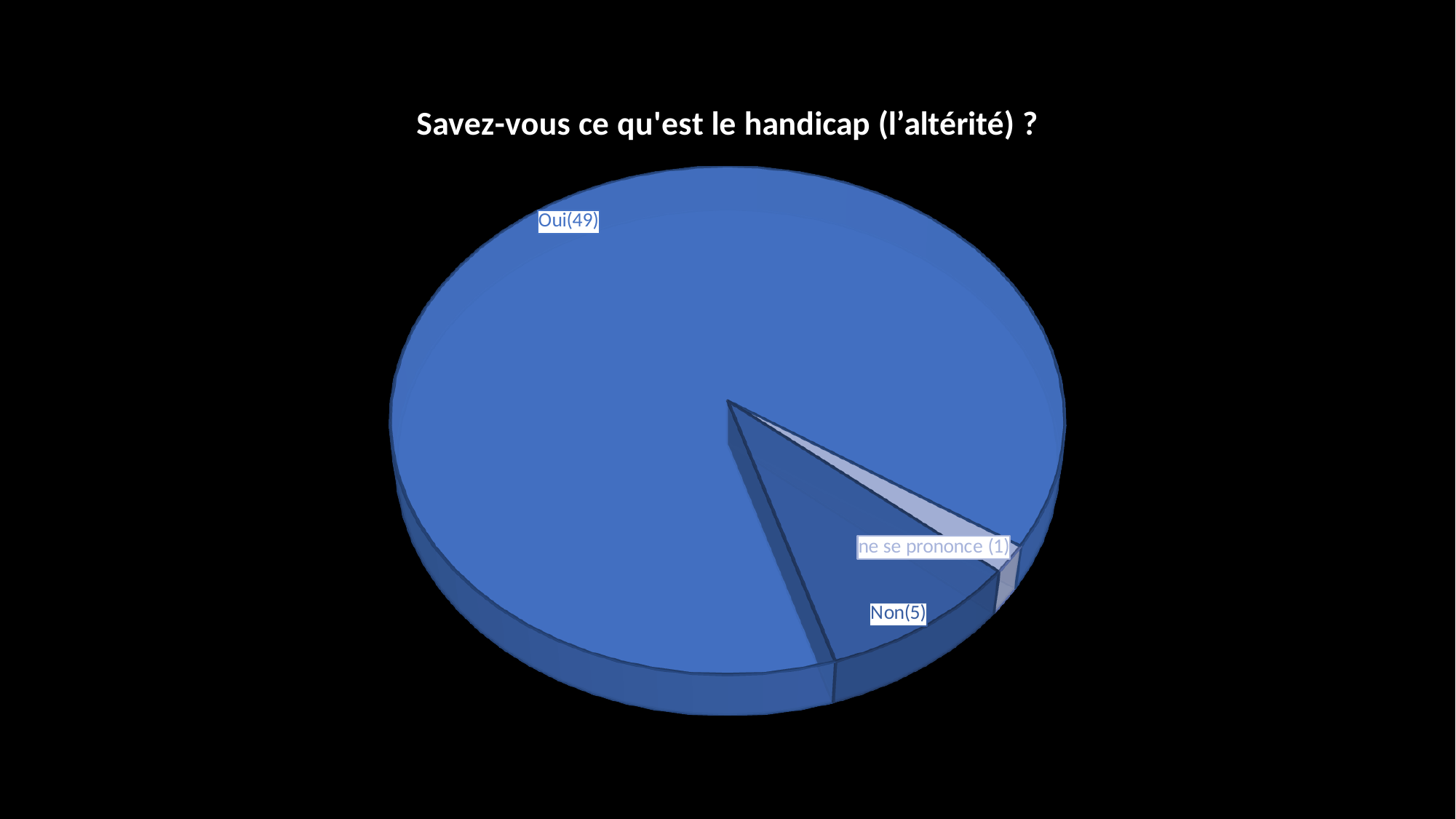
Which category has the largest slice? Oui Which category has the smallest slice? ne se prononce What is the title of the chart? Savez-vous ce qu'est le handicap (l’altérité) ? What is the value for ne se prononce? 1 What is the total of all slices in the pie chart? 55 How many slices does the pie chart have? 3 What is the difference between the values for Oui and Non? 44 What kind of chart is shown on the slide? pie chart What is the difference between the values for Non and ne se prononce? 4 What is the value for Oui? 49 Which is larger, the value for Non or the value for ne se prononce? Non What is the value for Non? 5